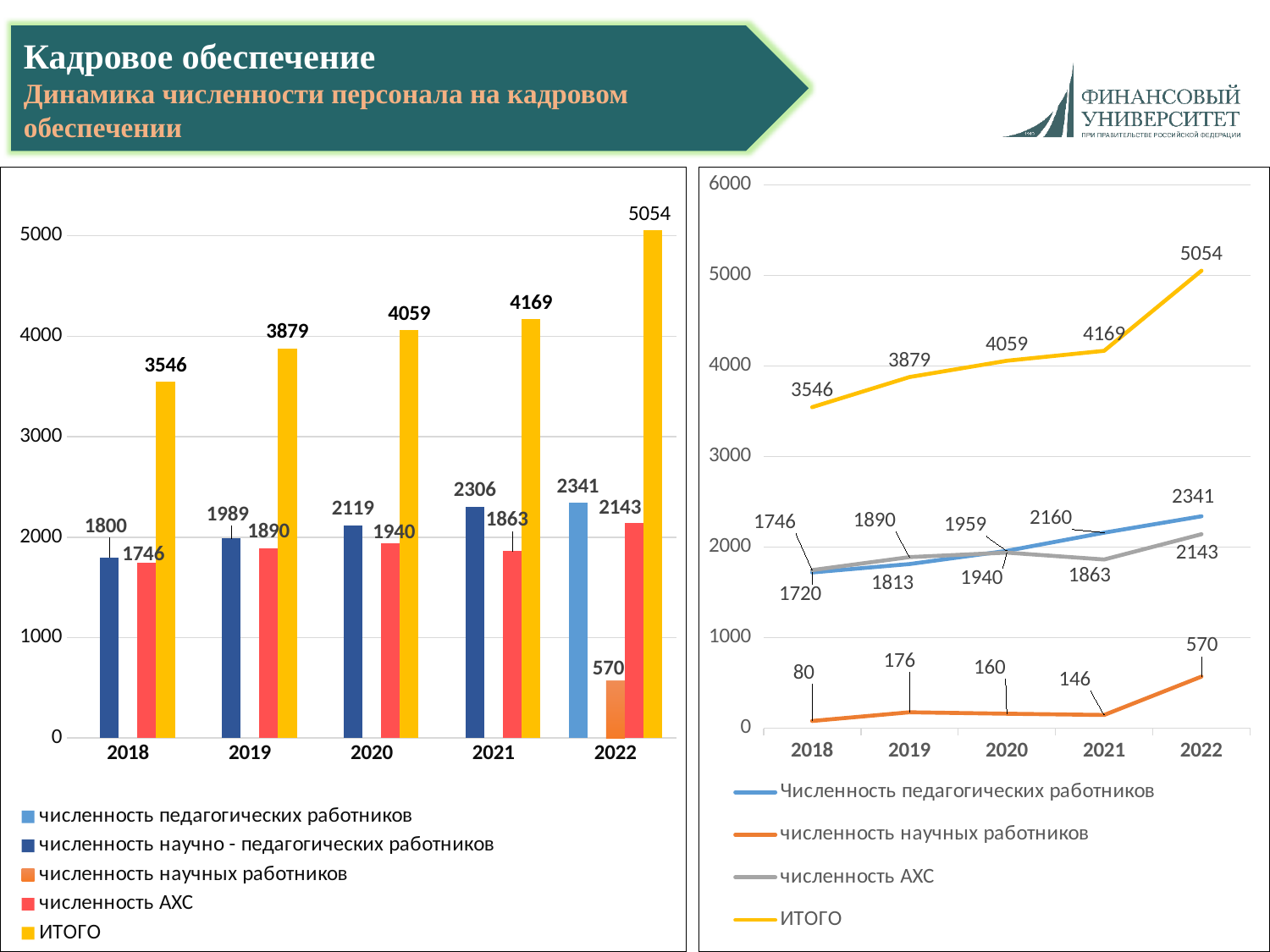
In the right line chart, what is the value for численность научных работников in 2019? 176 In the left bar chart, what is the value for численность научно - педагогических работников in 2019? 1989 In the right line chart, what is the value for Численность педагогических работников in 2020? 1959 What kind of chart is the chart on the right side of the slide? line chart In the left bar chart, how many series does the legend list? 5 In the right line chart, is the value for численность АХС in 2021 larger or smaller than the value for Численность педагогических работников in 2021? smaller In the left bar chart, what is the ИТОГО value for 2022? 5054 In the left bar chart, what is the value for численность научных работников in 2022? 570 In the left bar chart, which year has the lowest ИТОГО value? 2018 In the right line chart, does the ИТОГО series rise or fall from 2018 to 2022? rise In the right line chart, which year has the highest value for численность научных работников? 2022 In the left bar chart, what is the difference between the ИТОГО values for 2022 and 2021? 885